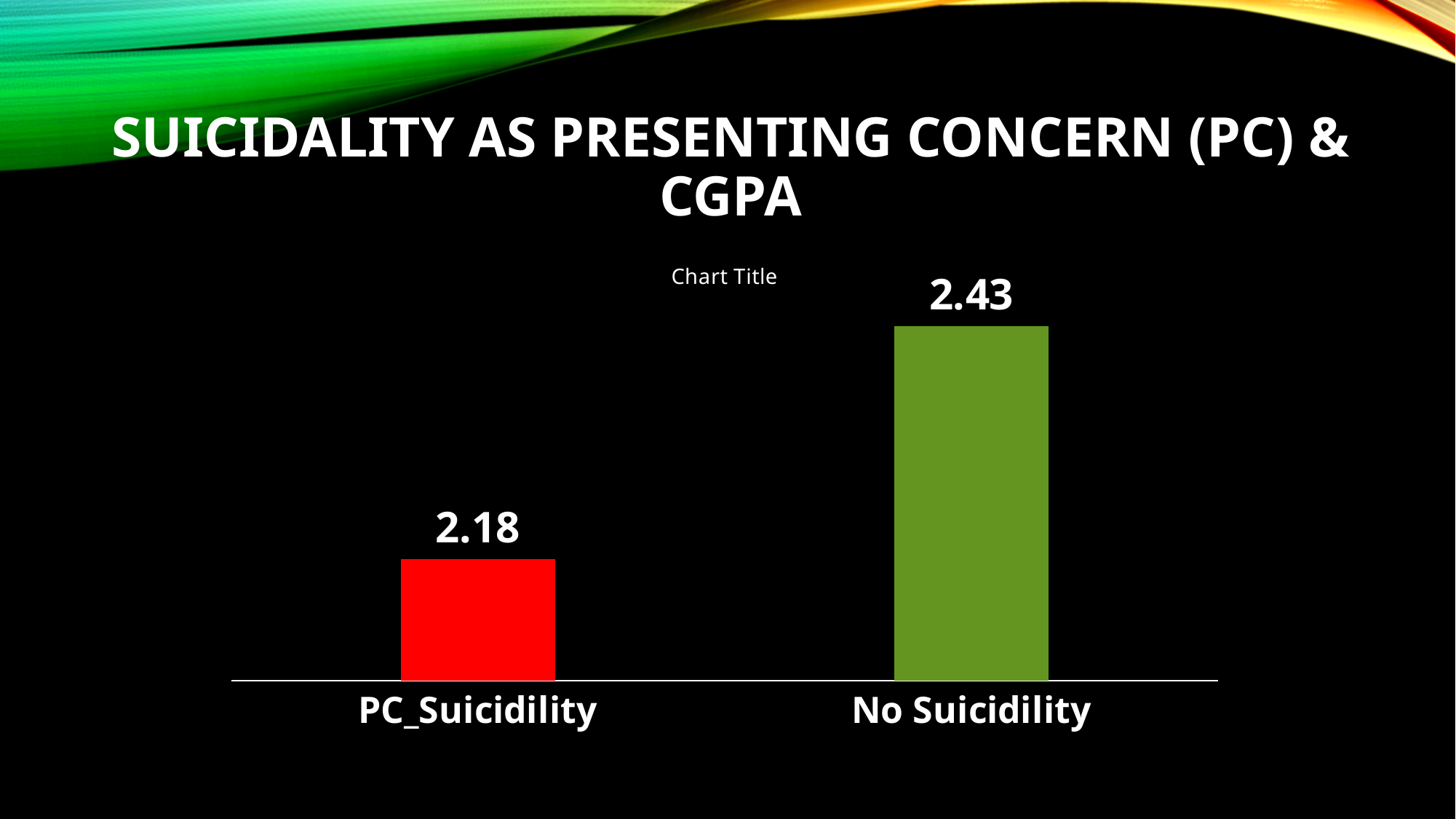
What kind of chart is shown on the slide? Bar chart What colour is the bar for PC_Suicidility? Red What is the title shown above the chart? Chart Title What is the value for No Suicidility? 2.43 How many categories are shown in the chart? 2 Which category has the lowest value? PC_Suicidility What is the difference between the values for No Suicidility and PC_Suicidility? 0.25 What is the value for PC_Suicidility? 2.18 Which category has the highest value? No Suicidility Which is larger, the value for PC_Suicidility or the value for No Suicidility? No Suicidility